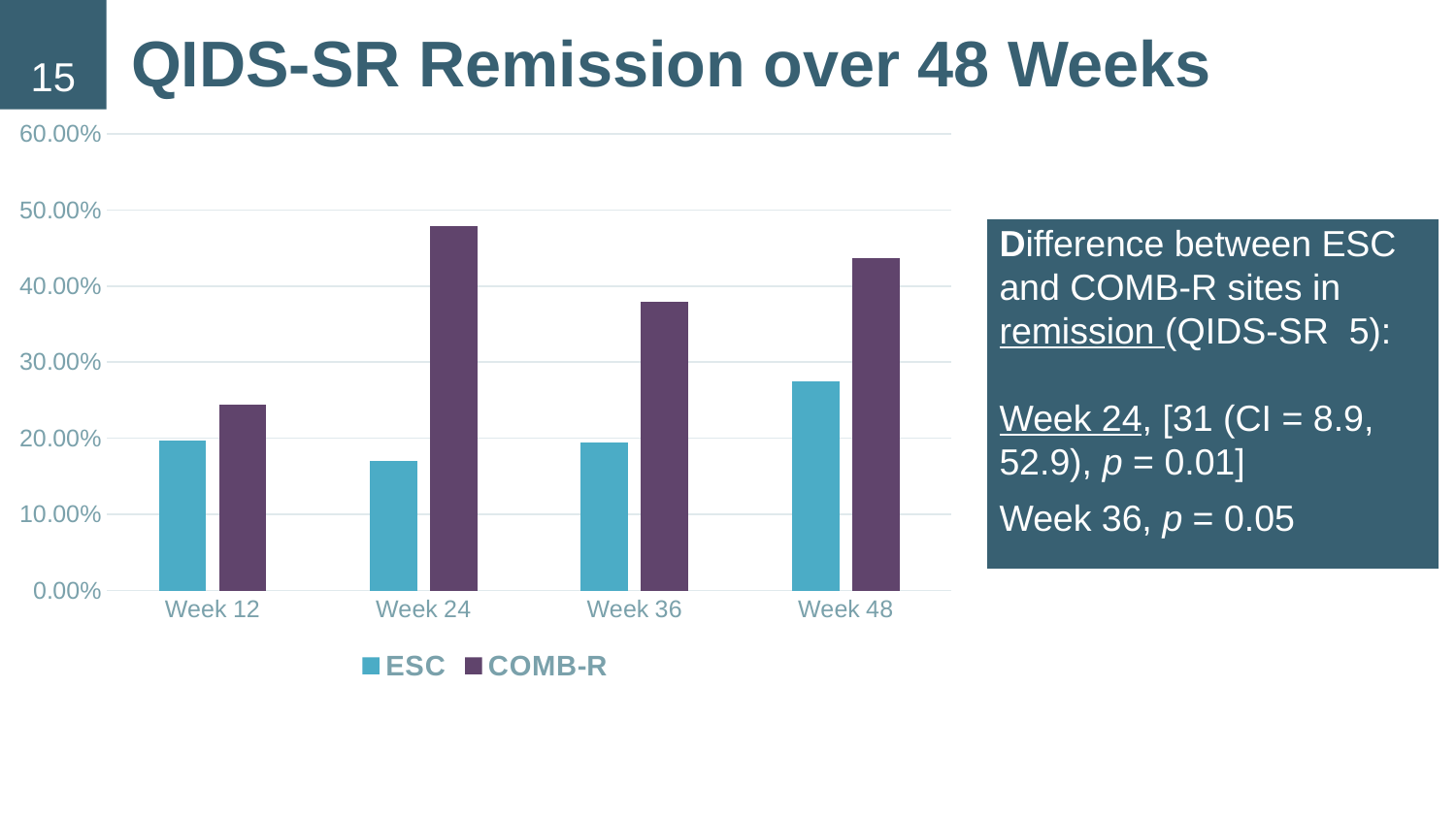
At which week is the COMB-R value highest? Week 24 How many series does the legend list? 2 Which series is shown in purple in the legend? COMB-R Does the COMB-R value rise or fall from Week 12 to Week 24? rise What is the title of the chart? QIDS-SR Remission over 48 Weeks At which week is the COMB-R value lowest? Week 12 Is the COMB-R value at Week 24 greater or less than 40.00%? greater Is the ESC value at Week 24 greater or less than 20.00%? less At Week 24, which series has the larger value, ESC or COMB-R? COMB-R How many week categories are shown on the x axis? 4 What kind of chart is shown on the slide? bar chart At which week is the ESC value highest? Week 48